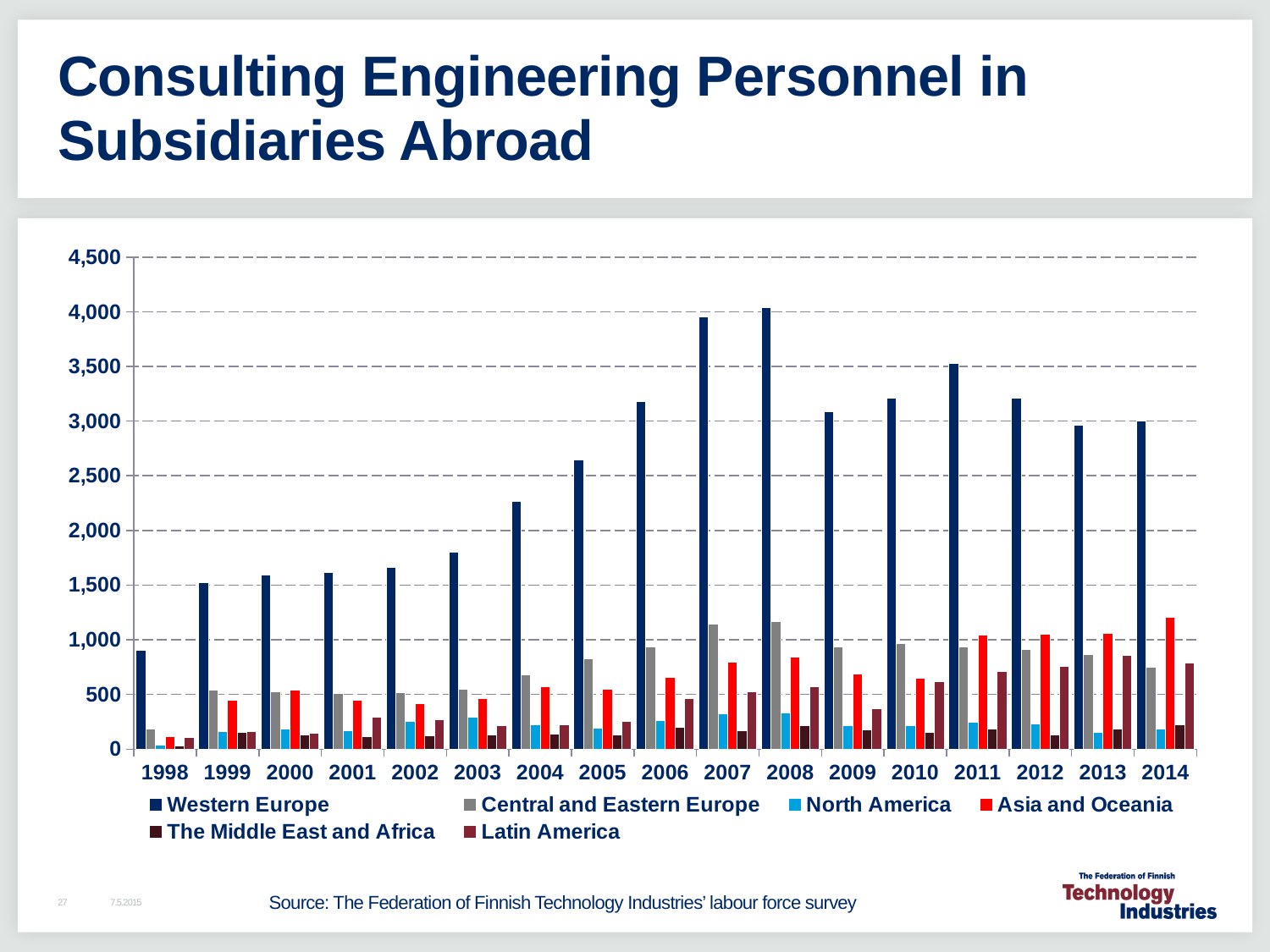
In which year is the Western Europe value lowest? 1998 How many years are shown on the x axis? 17 Is the value for Western Europe in 2005 greater or less than 2,500? greater In which year is the Western Europe value highest? 2008 Is the value for Western Europe in 1998 greater or less than 1,000? less How many series does the legend list? 6 Is the value for Asia and Oceania in 2014 greater or less than 1,000? greater What kind of chart is shown on the slide? bar chart Does the Western Europe value rise or fall from 1998 to 2008? rise What is the title of the chart on the slide? Consulting Engineering Personnel in Subsidiaries Abroad Which is larger, the Western Europe value in 2007 or in 2009? 2007